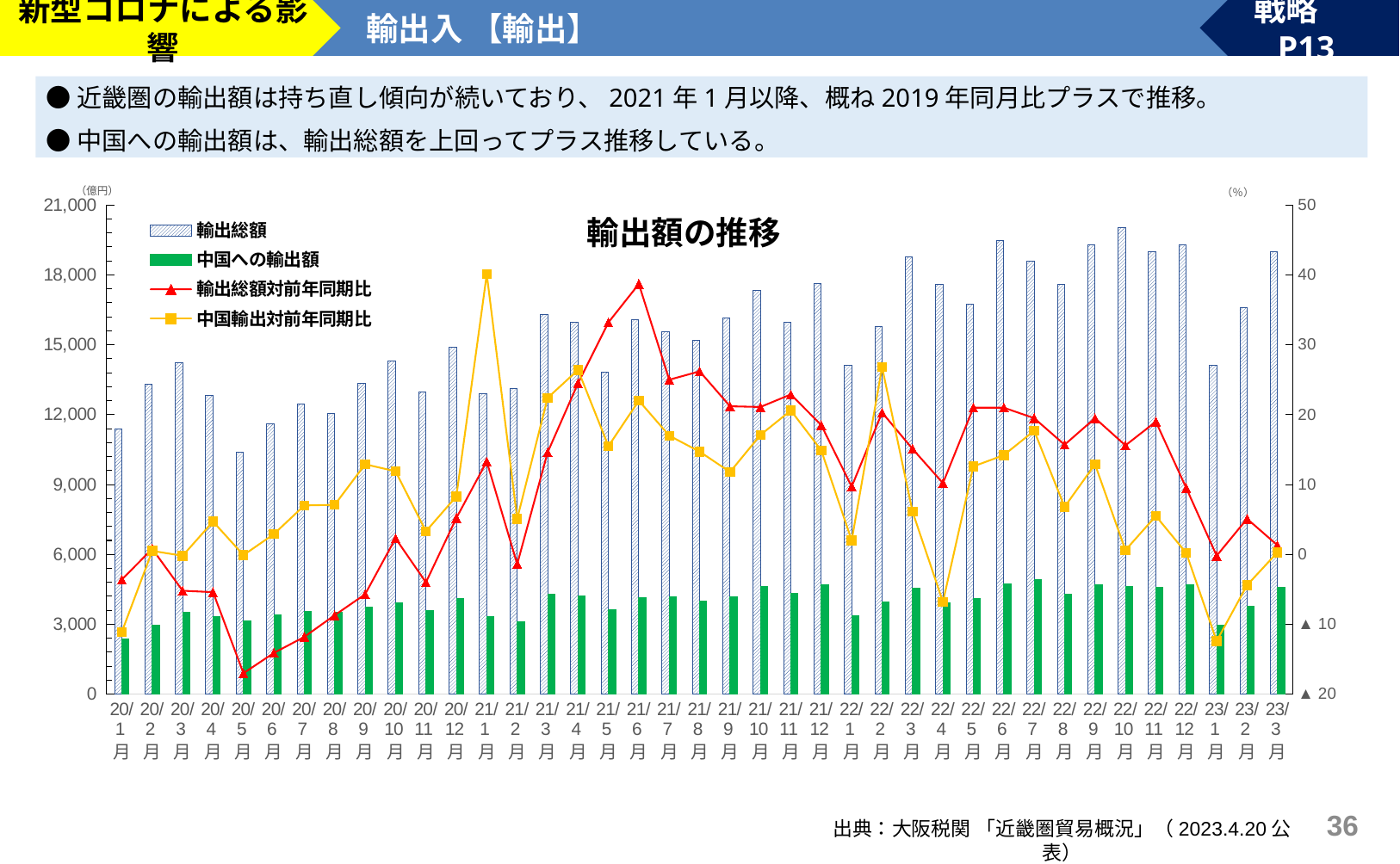
What is the title of the chart? 輸出額の推移 How many series does the chart legend list? 4 Is the 輸出総額 value for 20/5月 greater or less than 12,000? less Is the 輸出総額 value for 22/10月 greater or less than 18,000? greater In which month does the 中国輸出対前年同期比 line reach its highest point? 21/1月 Which month has the lowest 輸出総額 bar? 20/5月 In which month does the 輸出総額対前年同期比 line reach its lowest point? 20/5月 What kind of chart is shown on the slide? A combined bar and line chart Does the 輸出総額対前年同期比 line rise or fall from 21/2月 to 21/6月? rise Which is larger, the 輸出総額 bar for 20/1月 or for 20/3月? 20/3月 In which month does the 輸出総額対前年同期比 line reach its highest point? 21/6月 How many months are plotted along the x axis of the chart? 39